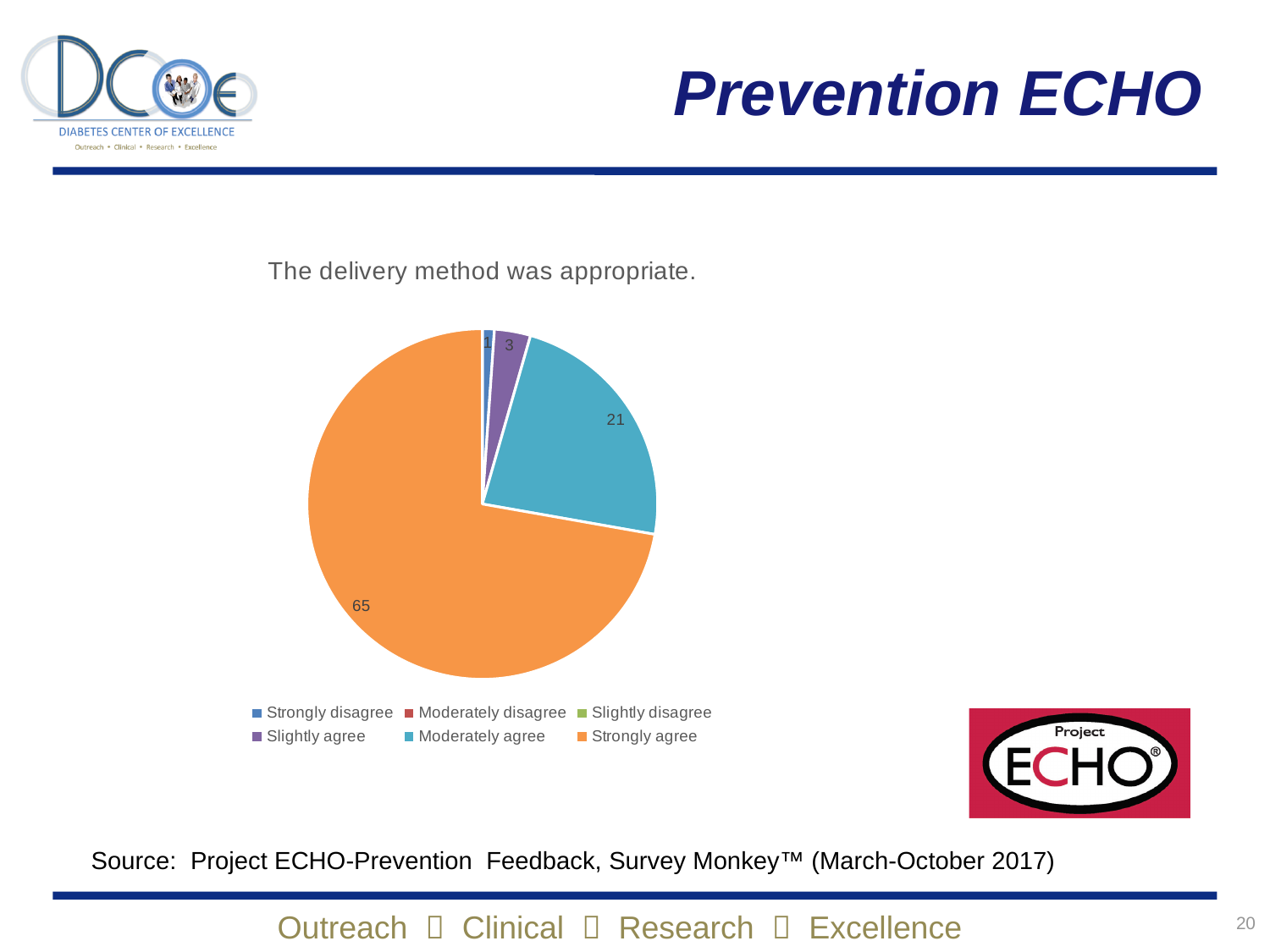
What is the value for Slightly agree in the pie chart? 3 Which category has the largest slice of the pie chart? Strongly agree What is the value for Moderately agree in the pie chart? 21 Which is larger, the value for Moderately agree or the value for Slightly agree? Moderately agree What is the title of the pie chart? The delivery method was appropriate. What kind of chart is shown on the slide? pie chart How many entries does the legend of the pie chart list? 6 What is the value for Strongly disagree in the pie chart? 1 What is the value for Strongly agree in the pie chart? 65 What is the difference between the values for Moderately agree and Slightly agree? 18 What colour is the Strongly agree slice in the pie chart? orange What is the difference between the values for Strongly agree and Moderately agree? 44